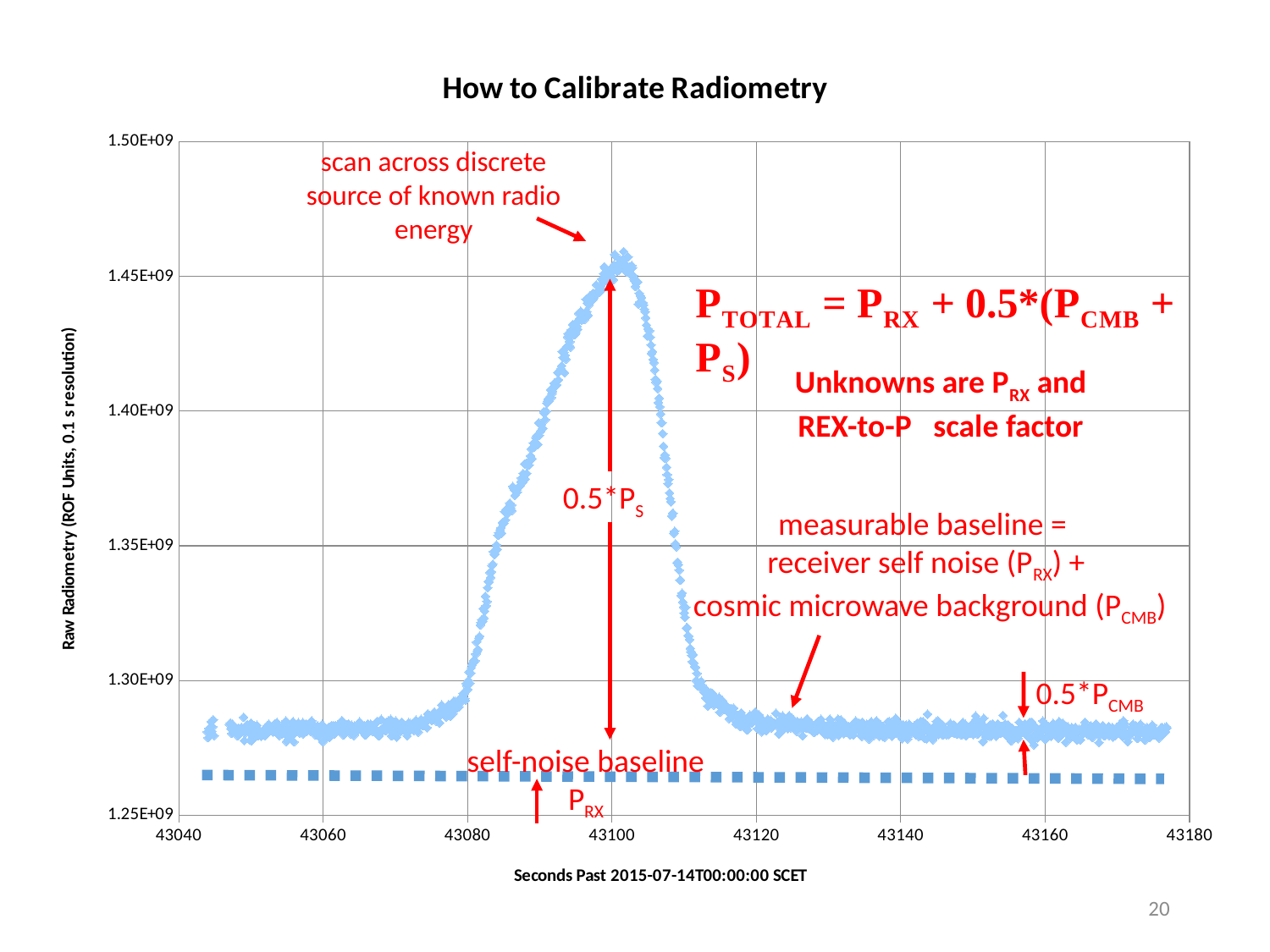
What kind of chart is shown on the slide? scatter chart Is the dotted self-noise baseline greater or less than 1.25E+09? greater Is the peak value of the light blue data series greater or less than 1.45E+09? greater Between 43100 and 43120 on the x axis, do the light blue values rise or fall? fall Is the light blue baseline value at 43060 greater or less than 1.30E+09? less How many tick labels are shown on the x axis? 8 Which is larger, the light blue value at 43100 or the light blue value at 43060? 43100 Between 43080 and 43100 on the x axis, do the light blue values rise or fall? rise Around which x-axis tick value does the peak of the light blue series occur? 43100 What is the label of the x axis? Seconds Past 2015-07-14T00:00:00 SCET What is the title of the chart? How to Calibrate Radiometry